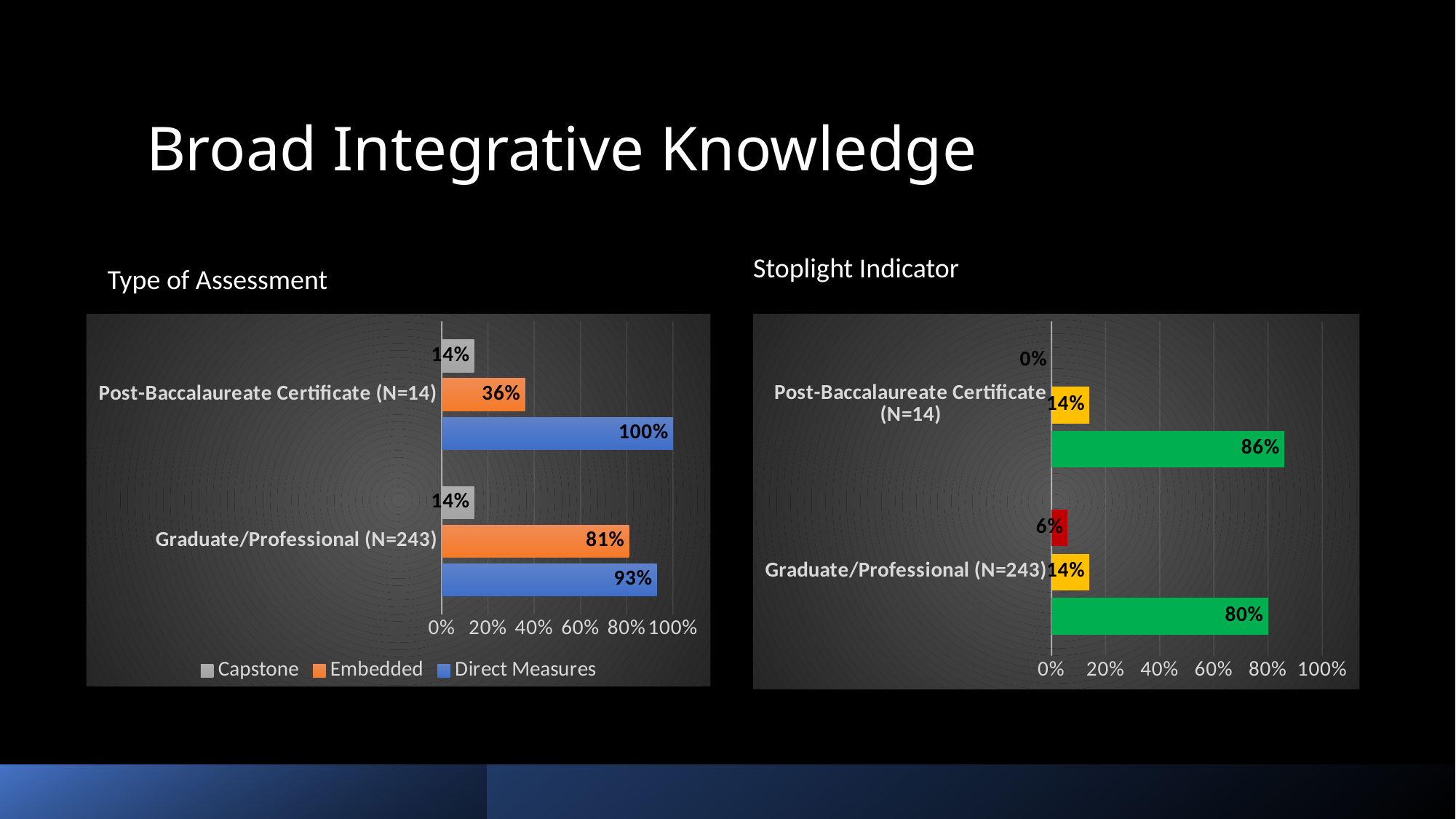
In the Type of Assessment chart, what is the Embedded value for Graduate/Professional (N=243)? 81% In the Type of Assessment chart, which is larger for Post-Baccalaureate Certificate (N=14): Embedded or Capstone? Embedded In the Type of Assessment chart, what is the Direct Measures value for Post-Baccalaureate Certificate (N=14)? 100% In the Stoplight Indicator chart, what is the green bar value for Post-Baccalaureate Certificate (N=14)? 86% In the Stoplight Indicator chart, what is the red bar value for Graduate/Professional (N=243)? 6% What kind of chart is the Stoplight Indicator chart? Bar chart In the Type of Assessment chart, what is the difference between the Embedded values for Graduate/Professional (N=243) and Post-Baccalaureate Certificate (N=14)? 45% In the Type of Assessment chart, how many series does the legend list? 3 How many categories are shown in the Stoplight Indicator chart? 2 In the Type of Assessment chart, which series has the highest value for Graduate/Professional (N=243)? Direct Measures In the Type of Assessment chart, what is the Capstone value for Post-Baccalaureate Certificate (N=14)? 14% In the Stoplight Indicator chart, what is the difference between the green bar values for Post-Baccalaureate Certificate (N=14) and Graduate/Professional (N=243)? 6%